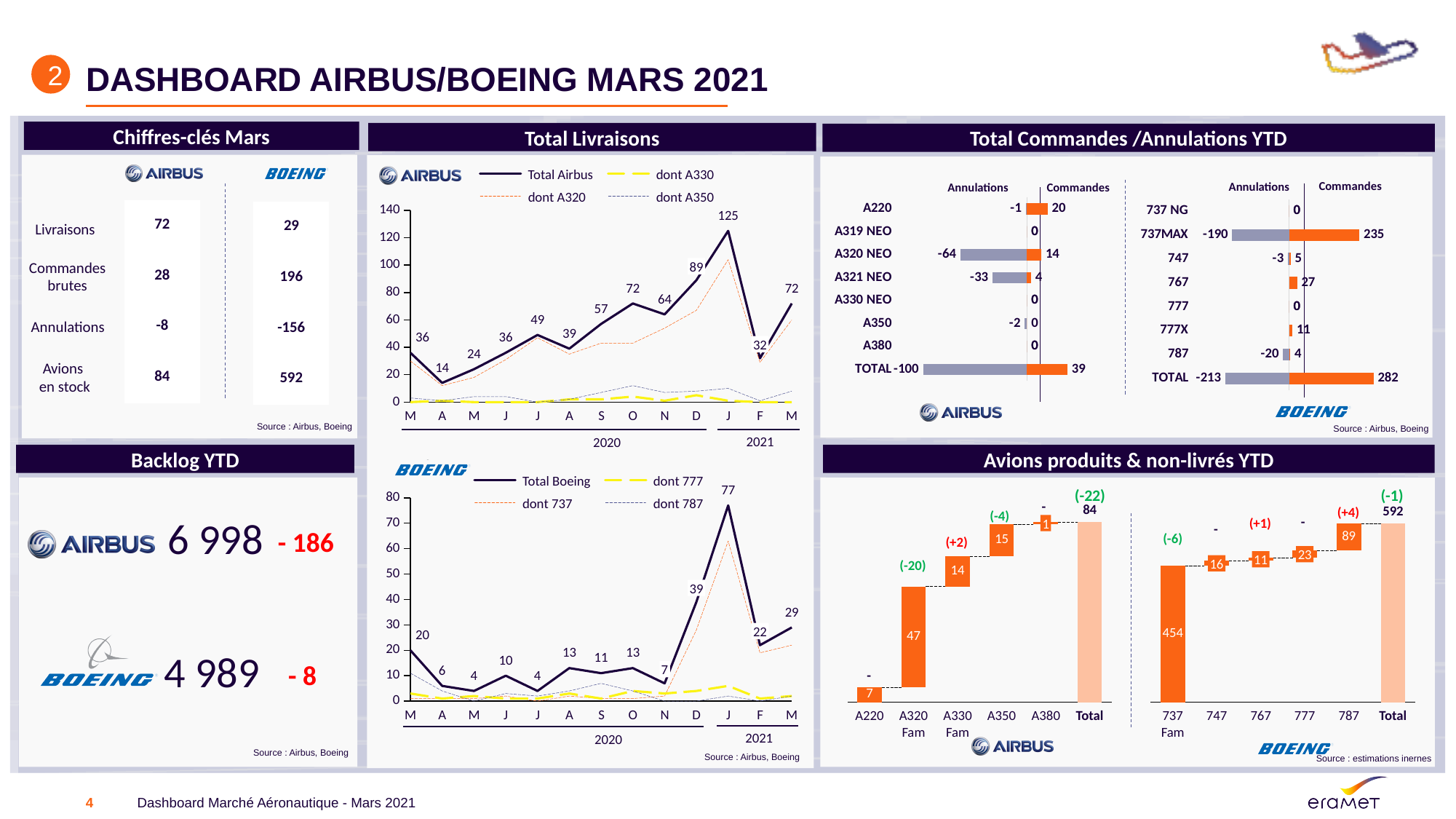
What kind of chart is used for Total Livraisons? Line chart In the Total Commandes/Annulations YTD Airbus chart, what is the Commandes value for A220? 20 In the Avions produits & non-livrés YTD Airbus chart, what is the value for A320 Fam? 47 In the Total Commandes/Annulations YTD Boeing chart, what is the Annulations value for 737MAX? -190 In the Total Livraisons Airbus line chart, how many series does the legend list? 4 In the Total Livraisons Airbus line chart, what is the Total Airbus value for D (December 2020)? 89 In the Total Livraisons Boeing line chart, what is the Total Boeing value for J (January 2021)? 77 In the Total Livraisons Airbus line chart, which month has the highest Total Airbus value? J (January 2021) In the Total Livraisons Boeing chart, how many months are plotted on the x axis? 13 In the Total Livraisons Airbus line chart, what is the difference between the Total Airbus values for D 2020 and J 2021? 36 In the Total Commandes/Annulations YTD Boeing chart, which model has the highest Commandes value? 737MAX In the Total Livraisons Boeing line chart, what is the difference between the Total Boeing values for J 2021 and D 2020? 38